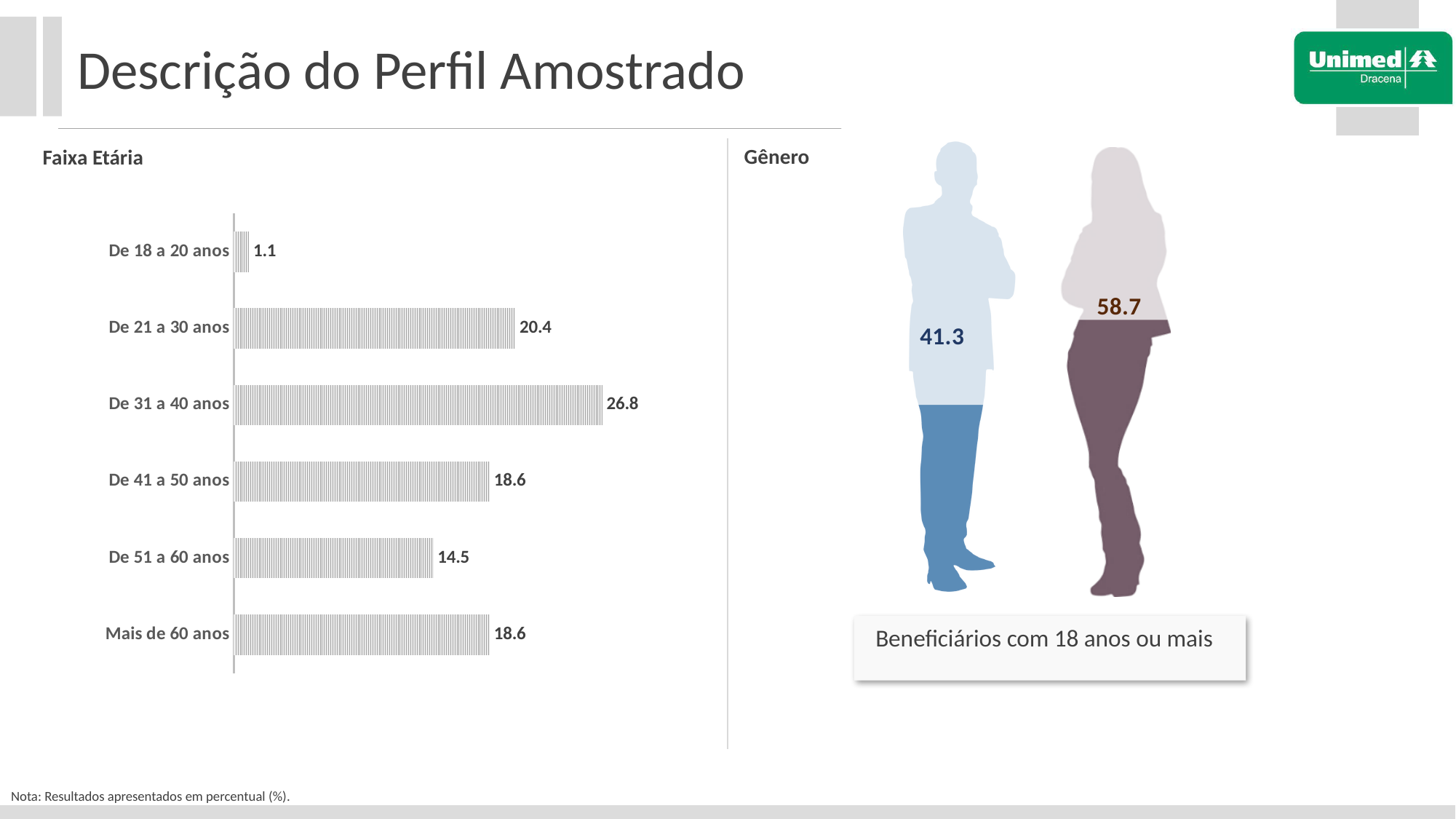
In the Faixa Etária chart, what is the difference between the values for De 41 a 50 anos and De 51 a 60 anos? 4.1 In the Faixa Etária chart, what is the value for De 31 a 40 anos? 26.8 In the Gênero graphic on the right, what is the value shown on the female figure? 58.7 In the Faixa Etária chart, which age group has the lowest value? De 18 a 20 anos How many age groups are shown in the Faixa Etária chart? 6 In the Faixa Etária chart, what is the value for De 18 a 20 anos? 1.1 What kind of chart is the Faixa Etária chart? Bar chart In the Faixa Etária chart, what is the value for De 51 a 60 anos? 14.5 In the Faixa Etária chart, which age group has the highest value? De 31 a 40 anos In the Faixa Etária chart, which is larger: the value for De 21 a 30 anos or De 51 a 60 anos? De 21 a 30 anos In the Faixa Etária chart, what is the difference between the values for De 31 a 40 anos and De 21 a 30 anos? 6.4 In the Gênero graphic on the right, what is the difference between the female and male values? 17.4